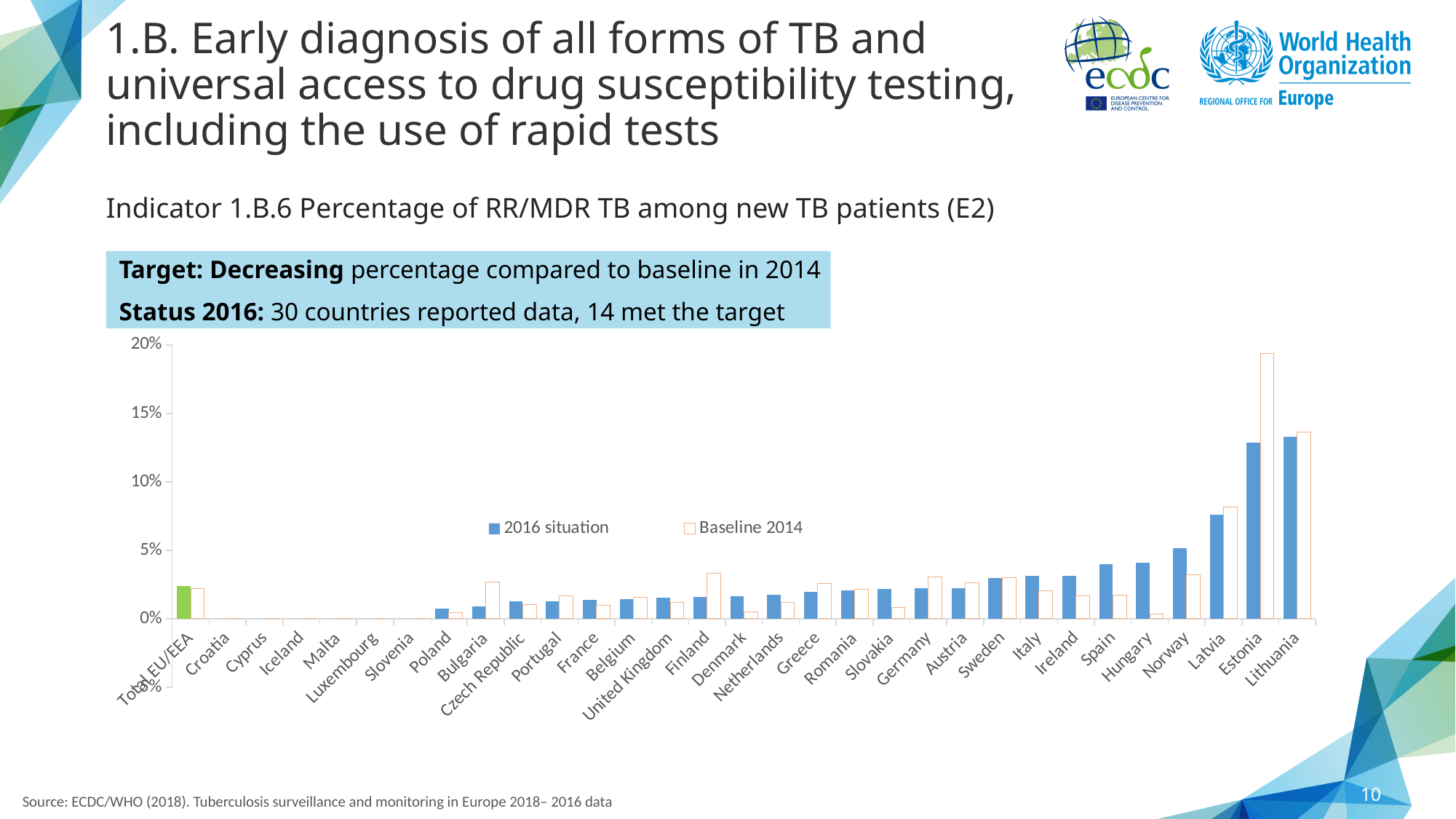
Is the 2016 situation value for Lithuania greater or less than 10%? greater Do the 2016 situation values generally rise or fall moving from left to right along the x axis? Rise Is the Baseline 2014 value for Estonia greater or less than 15%? greater For Estonia, which is larger: the 2016 situation value or the Baseline 2014 value? Baseline 2014 How many series does the chart legend list? 2 What are the two series named in the chart legend? 2016 situation and Baseline 2014 Which bar in the chart is coloured green rather than blue? Total EU/EEA Is the 2016 situation value for Latvia greater or less than 5%? greater For Norway, which is larger: the 2016 situation value or the Baseline 2014 value? 2016 situation How many categories are shown along the x axis of the chart? 31 Which country has the highest Baseline 2014 value in the chart? Estonia What kind of chart is shown on the slide? Bar chart